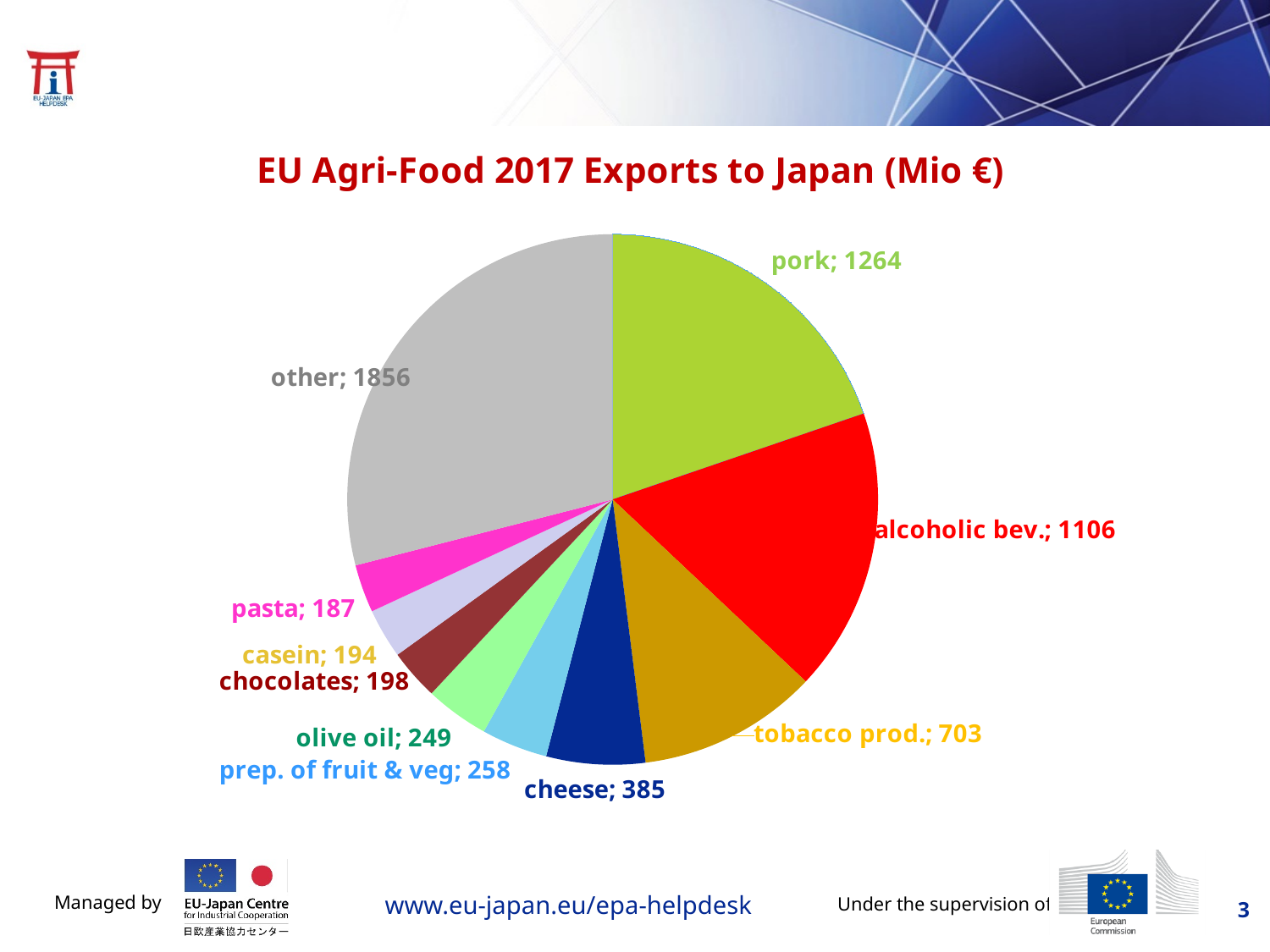
What is the value for pork in the pie chart? 1264 What is the value for tobacco prod. in the pie chart? 703 What is the difference between the values for pork and alcoholic bev.? 158 Which is larger, the value for prep. of fruit & veg or the value for olive oil? prep. of fruit & veg What is the title of the chart? EU Agri-Food 2017 Exports to Japan (Mio €) Which slice of the pie chart has the smallest value? pasta How many slices does the pie chart have? 10 What is the difference between the values for tobacco prod. and cheese? 318 What type of chart is shown on the slide? pie chart Which slice of the pie chart has the largest value? other What is the value for cheese in the pie chart? 385 What is the value for casein in the pie chart? 194